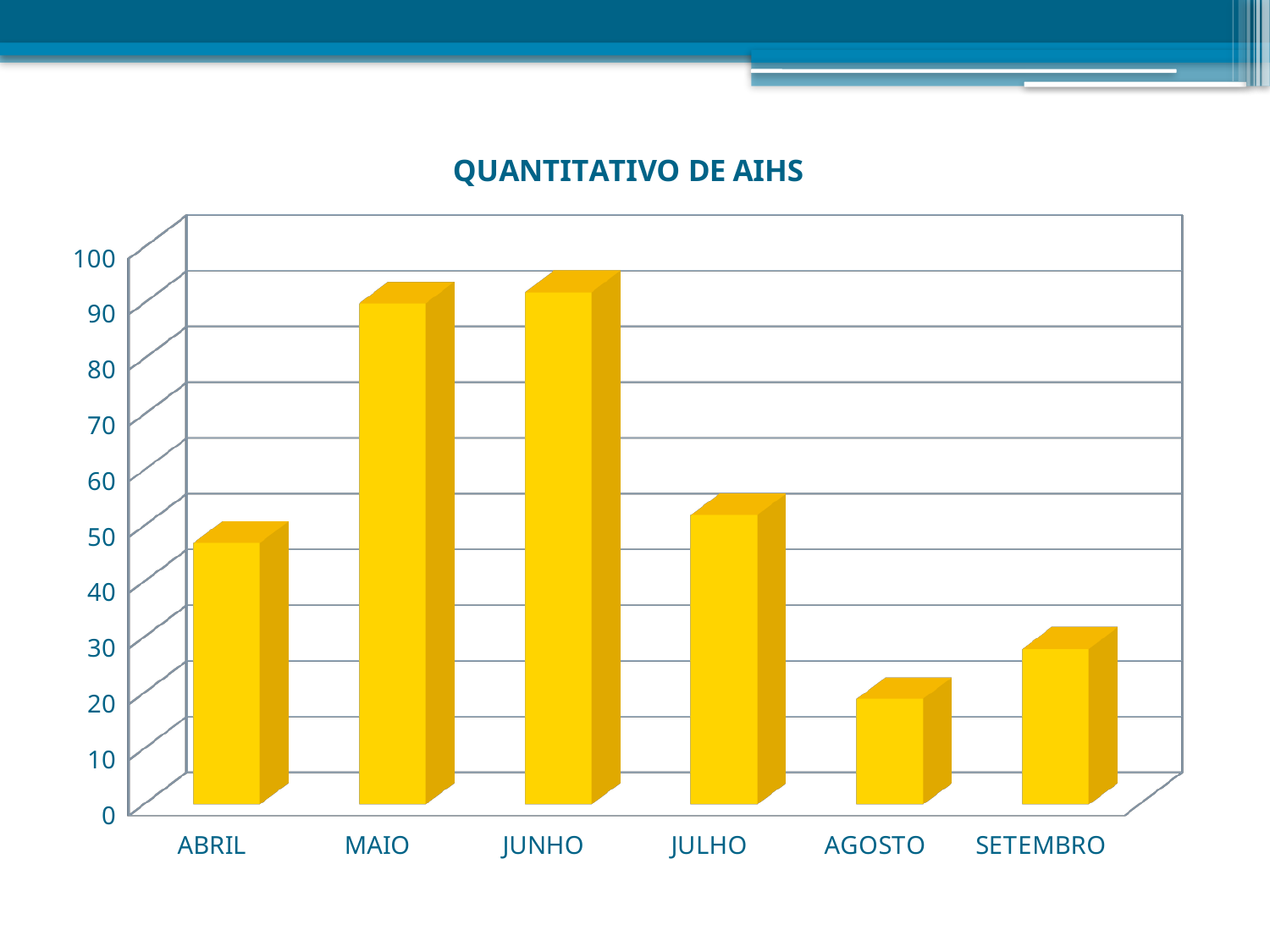
What kind of chart is shown on the slide? bar chart Is the value for AGOSTO greater or less than 30? less How many months are shown on the x axis of the chart? 6 Which month has the lowest value in the chart? AGOSTO Which is larger, the value for ABRIL or the value for JULHO? JULHO Is the value for SETEMBRO greater or less than 40? less Is the value for ABRIL greater or less than 40? greater What is the title of the chart? QUANTITATIVO DE AIHS Which is larger, the value for AGOSTO or the value for SETEMBRO? SETEMBRO Do the values rise or fall from JUNHO to AGOSTO? fall